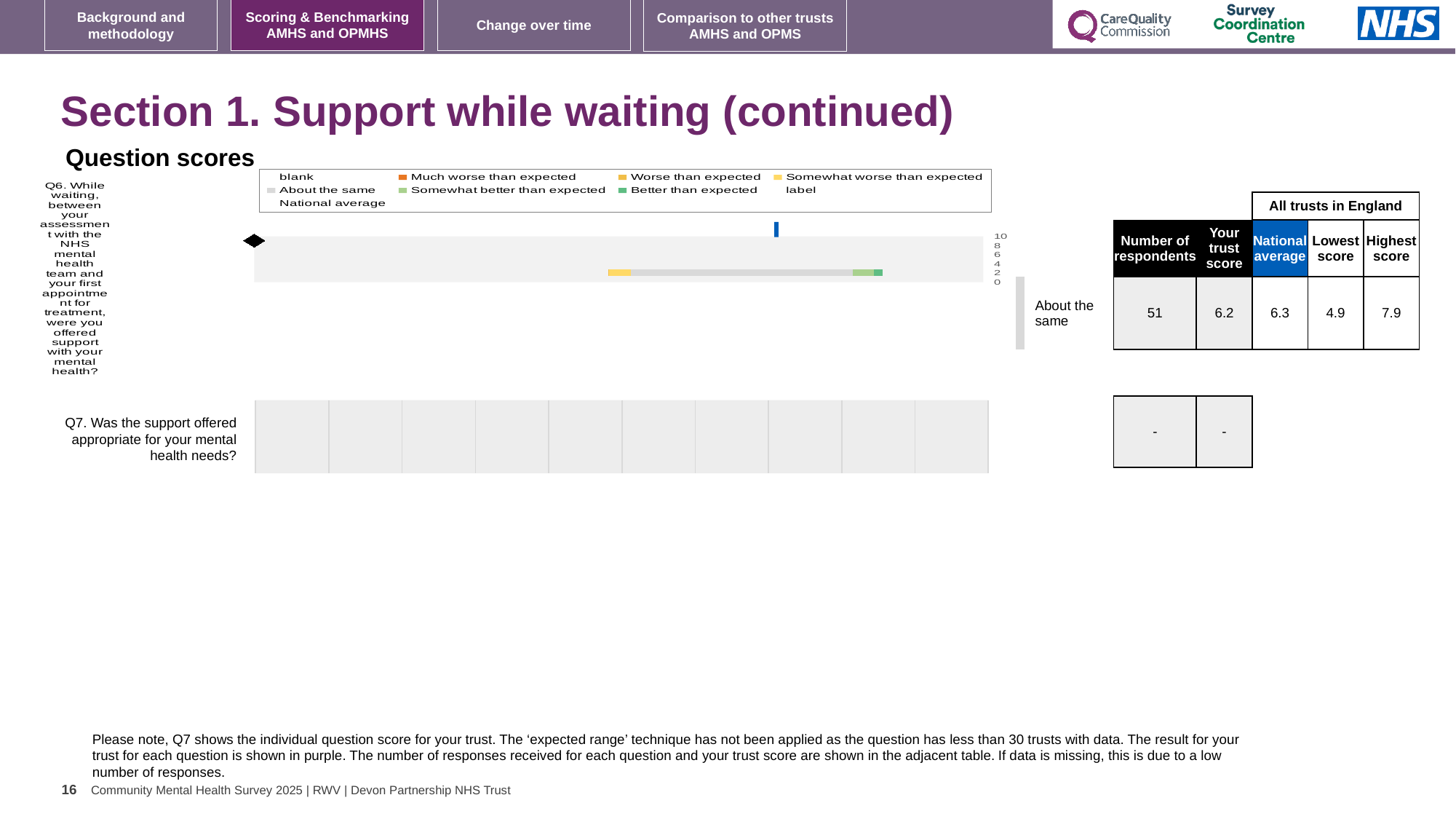
What is the national average score for Q6? 6.3 What colour does the legend use for 'Much worse than expected'? Orange What is the highest score among all trusts in England for Q6? 7.9 What is the trust score for Q6 (support with your mental health while waiting)? 6.2 Which is larger for Q6, the trust score or the national average? National average Is the trust score for Q6 greater or less than 5 on the chart axis? greater How is the trust's Q6 result categorised relative to the expected range? About the same What kind of chart is used for the Question scores? Bar chart What is the lowest score among all trusts in England for Q6? 4.9 How many respondents answered Q6? 51 What is the difference between the highest and lowest trust scores for Q6? 3.0